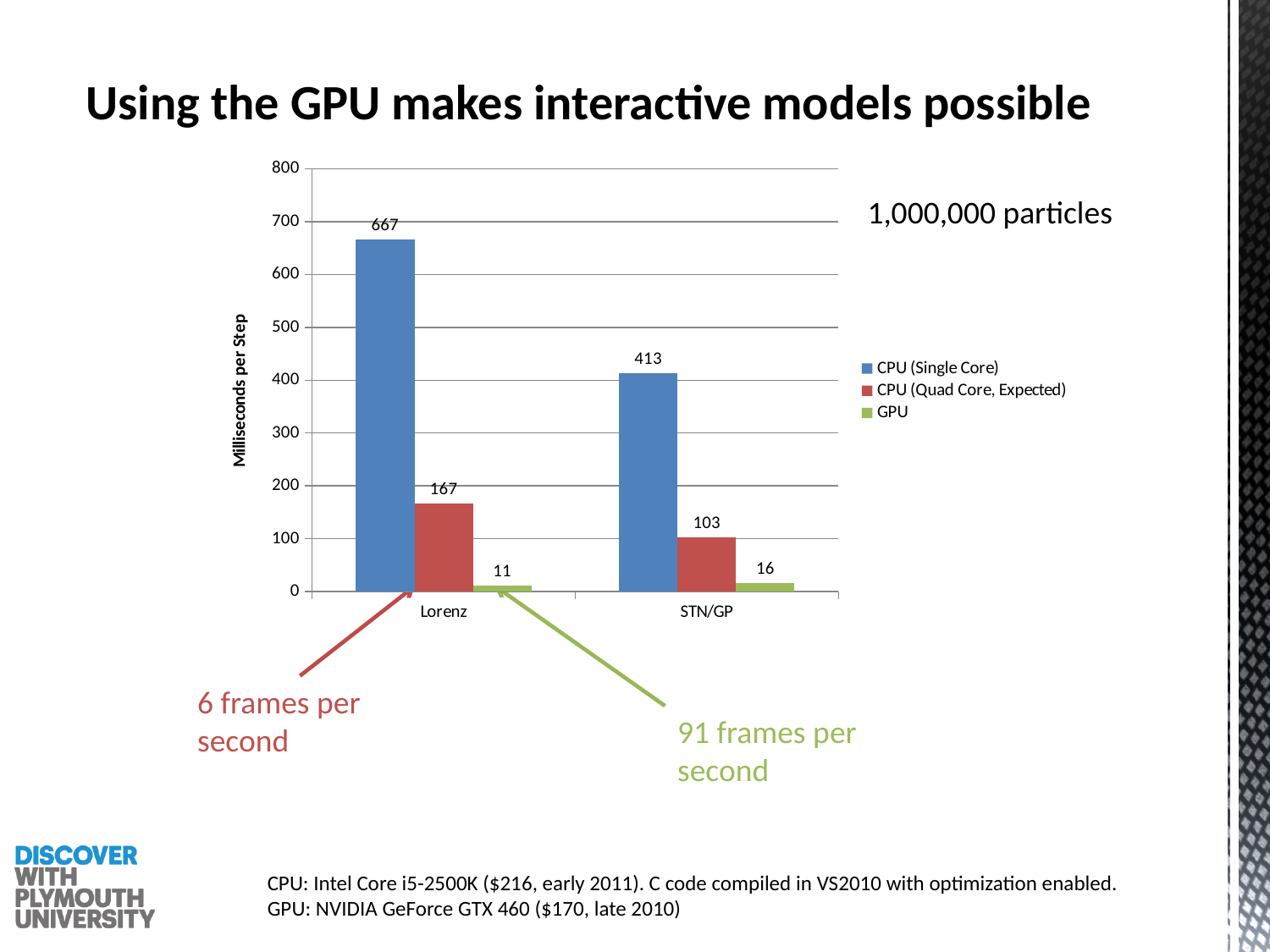
What is the value for GPU for STN/GP? 16 What is the difference between the CPU (Quad Core, Expected) and GPU values for Lorenz? 156 What is the value for CPU (Quad Core, Expected) for STN/GP? 103 Which series has the lowest value for STN/GP? GPU What is the label of the y axis? Milliseconds per Step Which series has the highest value for Lorenz? CPU (Single Core) How many series does the legend list? 3 What is the difference between the CPU (Single Core) values for Lorenz and STN/GP? 254 How many categories are shown on the x axis? 2 What is the value for CPU (Single Core) for Lorenz? 667 Which is larger, the GPU value for Lorenz or the GPU value for STN/GP? STN/GP What kind of chart is shown on the slide? Bar chart